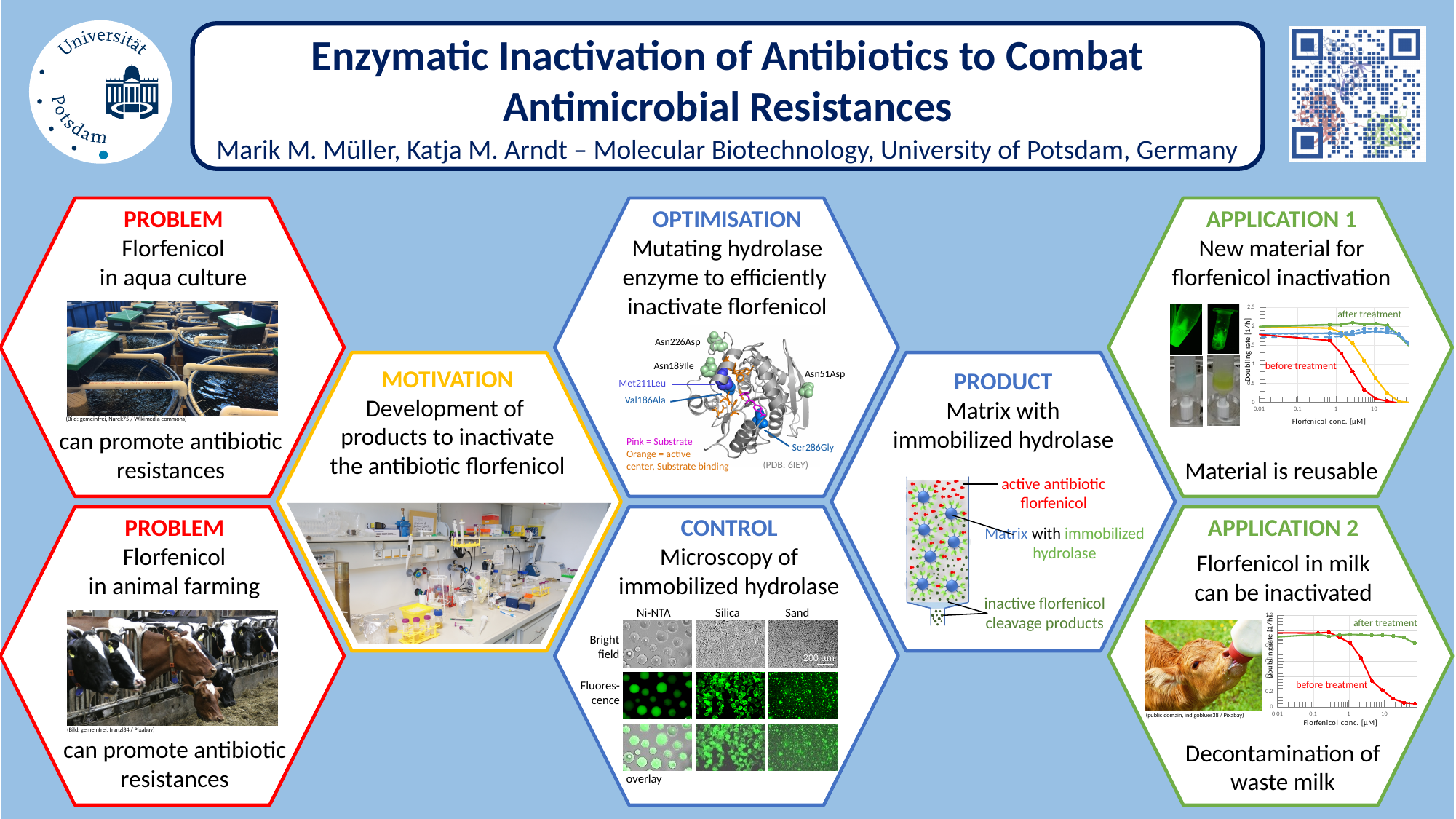
In the APPLICATION 2 chart, is the 'after treatment' doubling rate at 10 µM florfenicol greater or less than 0.4? greater In the APPLICATION 1 chart, is the 'before treatment' doubling rate at 10 µM florfenicol greater or less than 1? less What is the y-axis label of the APPLICATION 1 chart? Doubling rate [1/h] What is the x-axis label of the APPLICATION 2 chart? Florfenicol conc. [µM] In the APPLICATION 1 chart, does the 'before treatment' curve rise or fall as florfenicol concentration increases? fall In the APPLICATION 1 chart, at a florfenicol concentration of 10 µM, which curve has the higher doubling rate, 'after treatment' or 'before treatment'? after treatment How many charts are on the slide? 2 What kind of chart is shown in the APPLICATION 1 hexagon? line chart What kind of chart is shown in the APPLICATION 2 hexagon? line chart In the APPLICATION 2 chart, does the 'before treatment' curve rise or fall as florfenicol concentration increases? fall In the APPLICATION 2 chart, is the 'before treatment' doubling rate at 10 µM florfenicol greater or less than 0.4? less In the APPLICATION 2 chart, at a florfenicol concentration of 10 µM, which curve has the higher doubling rate, 'after treatment' or 'before treatment'? after treatment